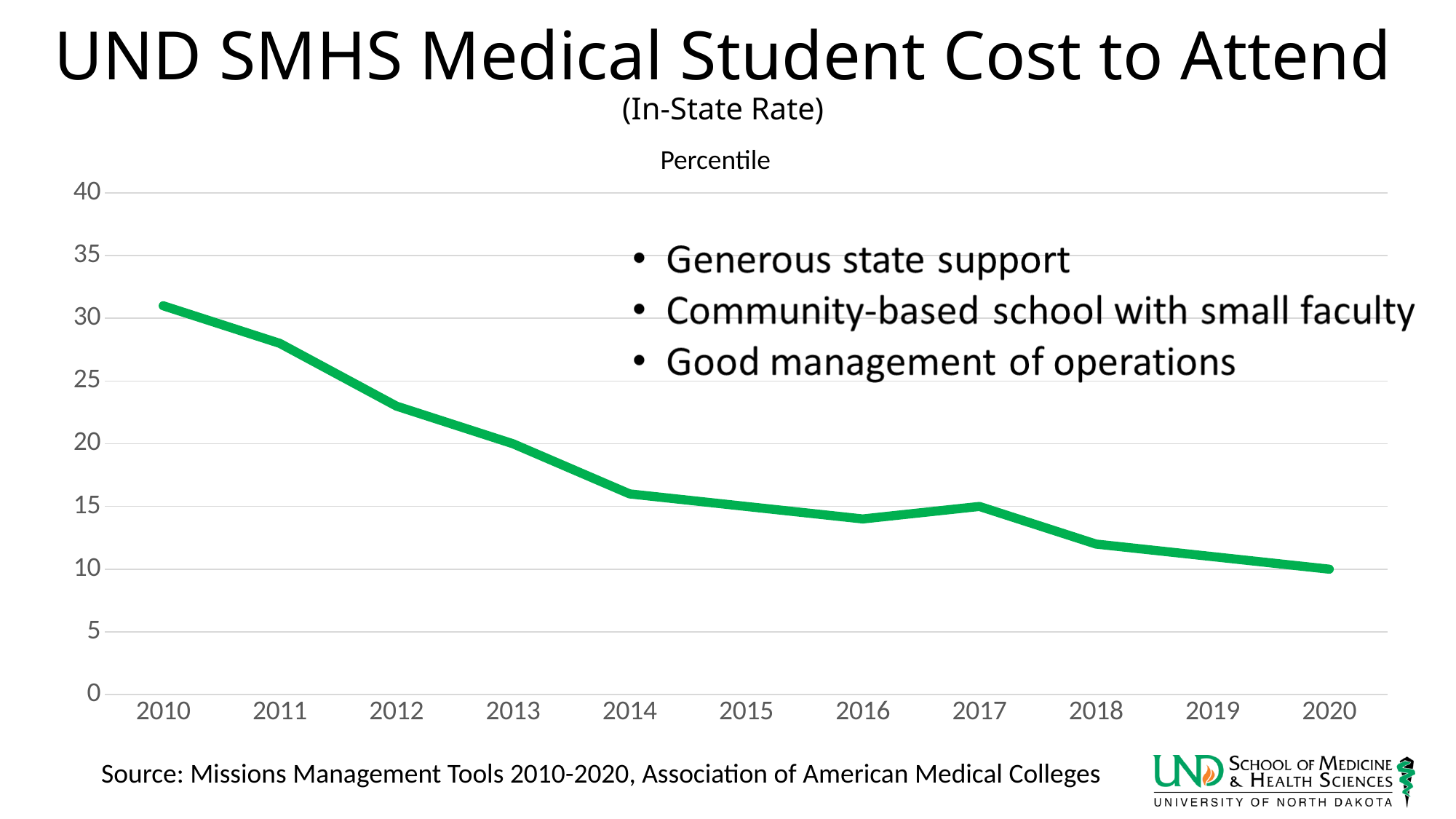
What is the percentile value for 2020? 10 Is the value for 2012 greater or less than 25? less Is the value for 2014 greater or less than 15? greater What label is shown above the y axis of the chart? Percentile Is the value for 2010 greater or less than 30? greater Do the values generally rise or fall from 2010 to 2020? fall Which year has the lowest percentile value? 2020 What kind of chart is shown on the slide? line chart How many years are plotted along the x axis? 11 Which year has the larger value, 2011 or 2017? 2011 Which year has the highest percentile value? 2010